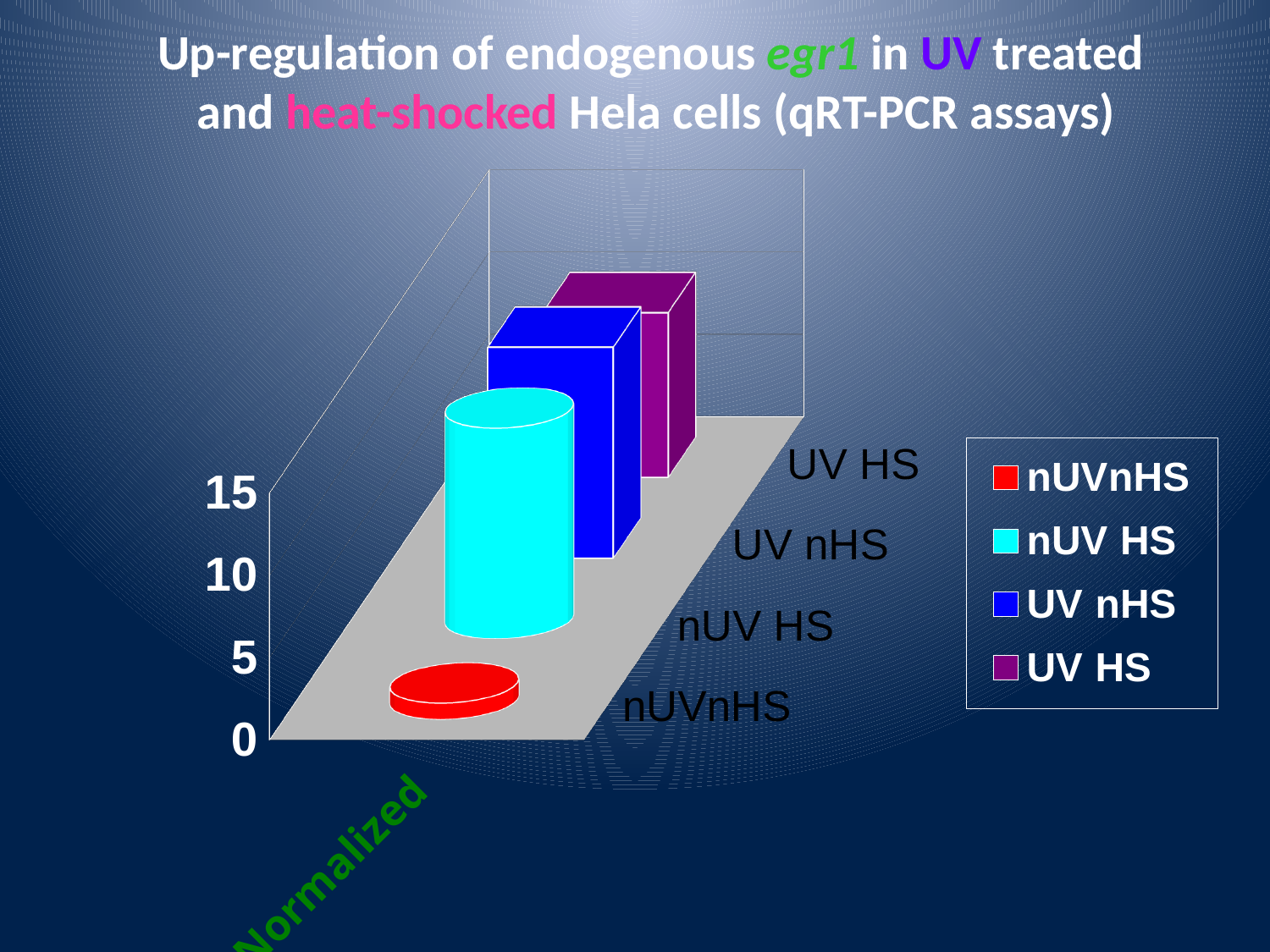
Is the value for nUVnHS greater or less than 5? less Is the value for nUV HS greater or less than 5? greater Is the value for UV nHS greater or less than 5? greater How many entries does the legend list? 4 Which category has the lowest value in the chart? nUVnHS What is the highest tick value shown on the vertical axis? 15 What kind of chart is shown on the slide? bar chart Which has the larger value, nUVnHS or nUV HS? nUV HS What colour represents UV HS in the legend? purple Which has the larger value, nUVnHS or UV nHS? UV nHS How many categories are plotted in the chart? 4